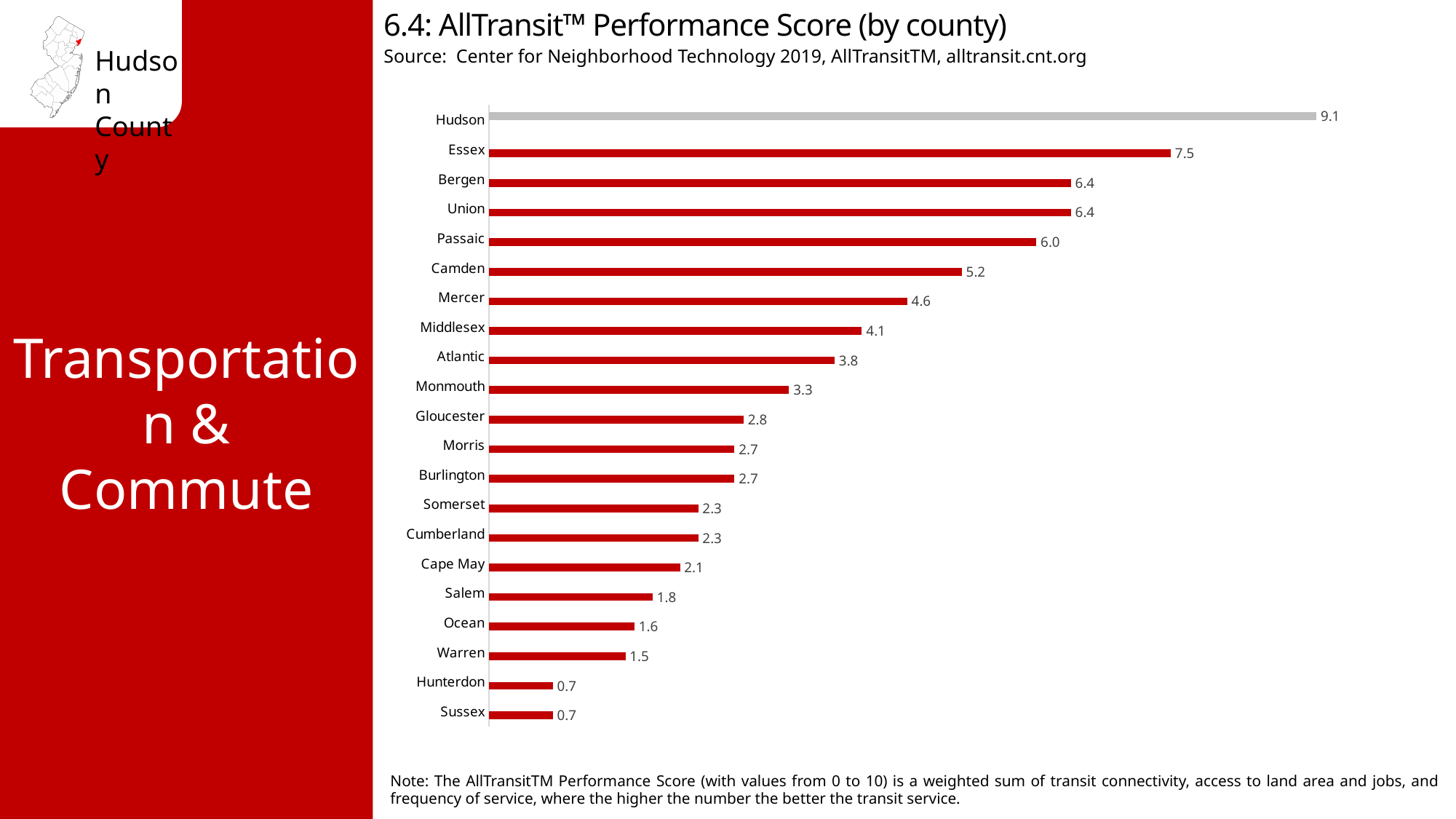
Which has a higher score, Salem or Warren? Salem How many counties are shown in the chart? 21 What is the difference between the scores of Passaic and Mercer? 1.4 Which has a higher score, Middlesex or Monmouth? Middlesex What is the AllTransit Performance Score for Cape May? 2.1 What kind of chart is used to show the AllTransit Performance Scores? Bar chart What is the difference between the scores of Hudson and Essex? 1.6 Do the scores rise or fall going down the list of counties from Hudson to Sussex? Fall What is the AllTransit Performance Score for Hudson County? 9.1 Which county's bar is shown in a different colour (grey) from the others? Hudson What is the AllTransit Performance Score for Camden? 5.2 Which county has the highest AllTransit Performance Score? Hudson